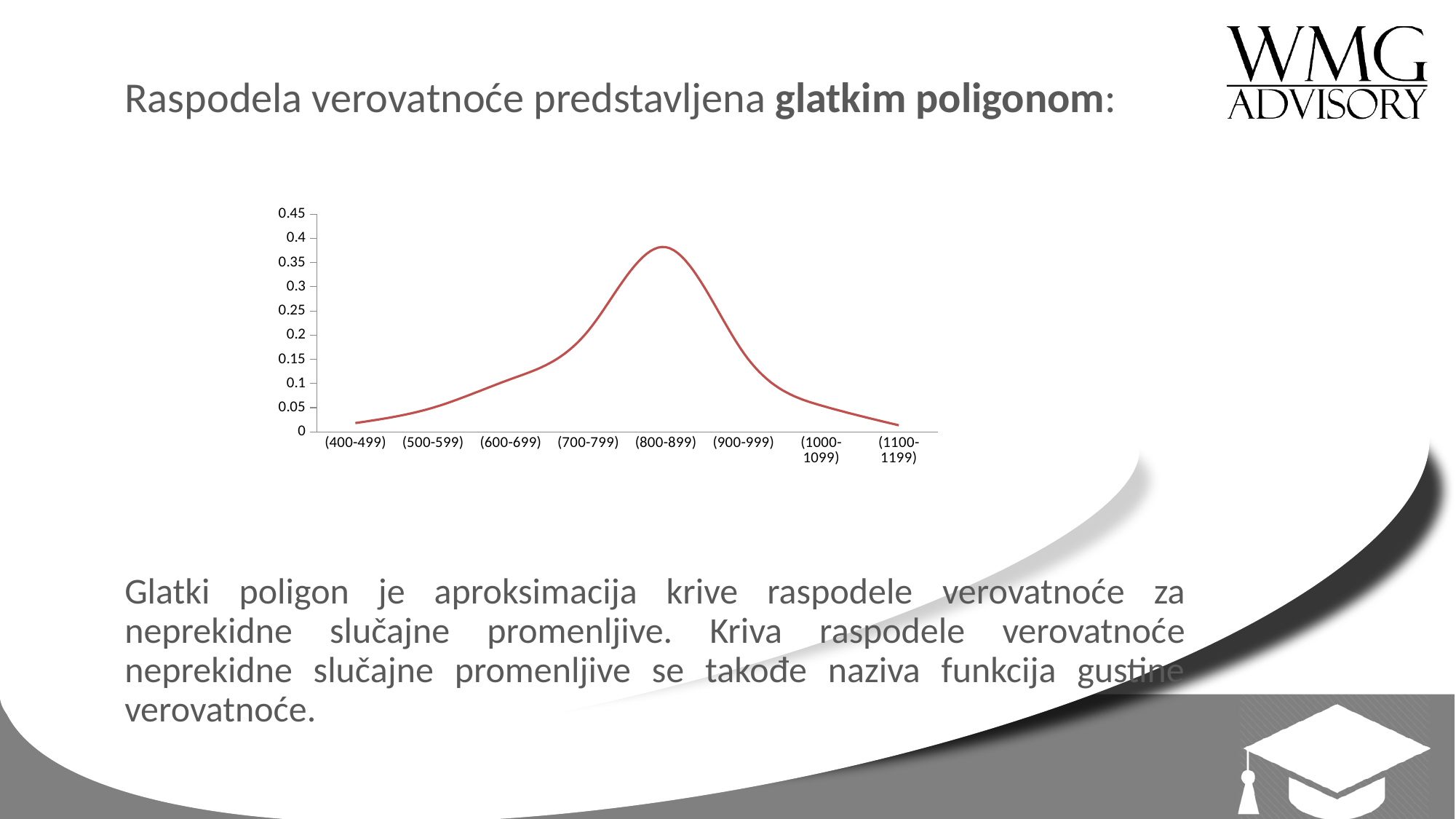
What kind of chart is shown on the slide? line chart What is the highest tick value shown on the y axis of the chart? 0.45 Is the value for (400-499) greater or less than 0.05? less Do the values rise or fall along the x axis from (800-899) to (1100-1199)? fall Which is larger, the value for (700-799) or the value for (900-999)? (700-799) How many categories are shown on the x axis of the chart? 8 Is the value for (800-899) greater or less than 0.35? greater Is the value for (1000-1099) greater or less than 0.1? less Which is larger, the value for (600-699) or the value for (1000-1099)? (600-699) Which category has the highest value on the chart? (800-899)